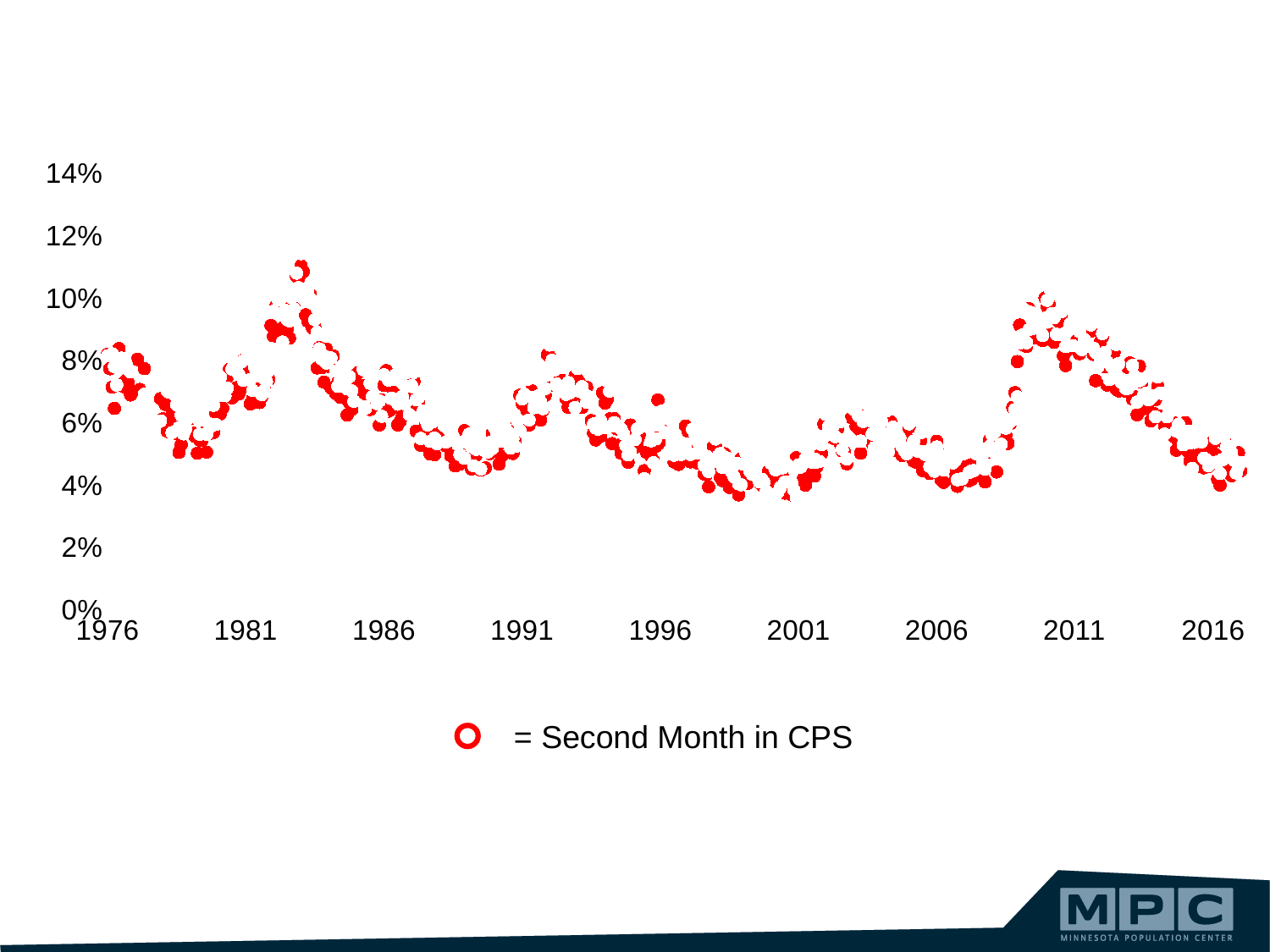
Which period shows the higher values: around 1983 or around 2000? around 1983 Are the values around 2010 greater or less than 8%? greater Are the values at the end of the series, around 2016, greater or less than 6%? less Do the values rise or fall between 1979 and 1983? rise What does the legend say the red circle marker represents? Second Month in CPS What kind of chart is shown on the slide? scatter chart Is the peak value reached around 1983 greater or less than 10%? greater How many year labels are shown along the horizontal axis? 9 Do the values rise or fall between 2010 and 2016? fall How many series does the legend list? 1 What is the highest value labelled on the vertical axis? 14%